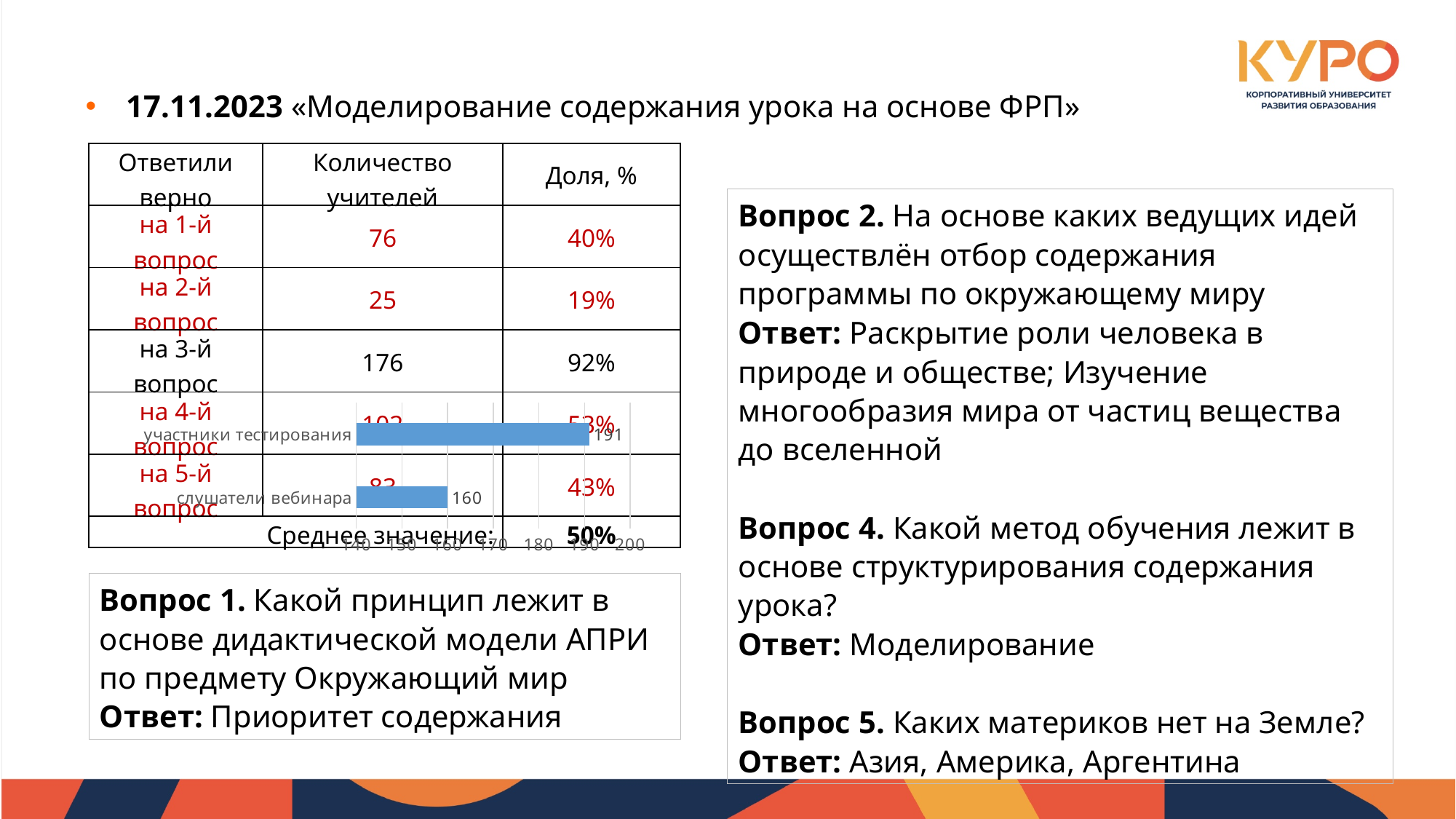
What is the highest tick value shown on the chart's axis? 200 Which is larger: the value for участники тестирования or for слушатели вебинара? участники тестирования Which category has the lowest value in the bar chart? слушатели вебинара What is the value for участники тестирования in the bar chart? 191 What is the difference between the values for участники тестирования and слушатели вебинара? 31 What type of chart is shown on the slide? bar chart What is the value for слушатели вебинара in the bar chart? 160 How many categories are plotted in the bar chart? 2 Is the value for слушатели вебинара greater or less than 170? less Is the value for участники тестирования greater or less than 180? greater What colour are the bars in the chart? blue Which category has the highest value in the bar chart? участники тестирования